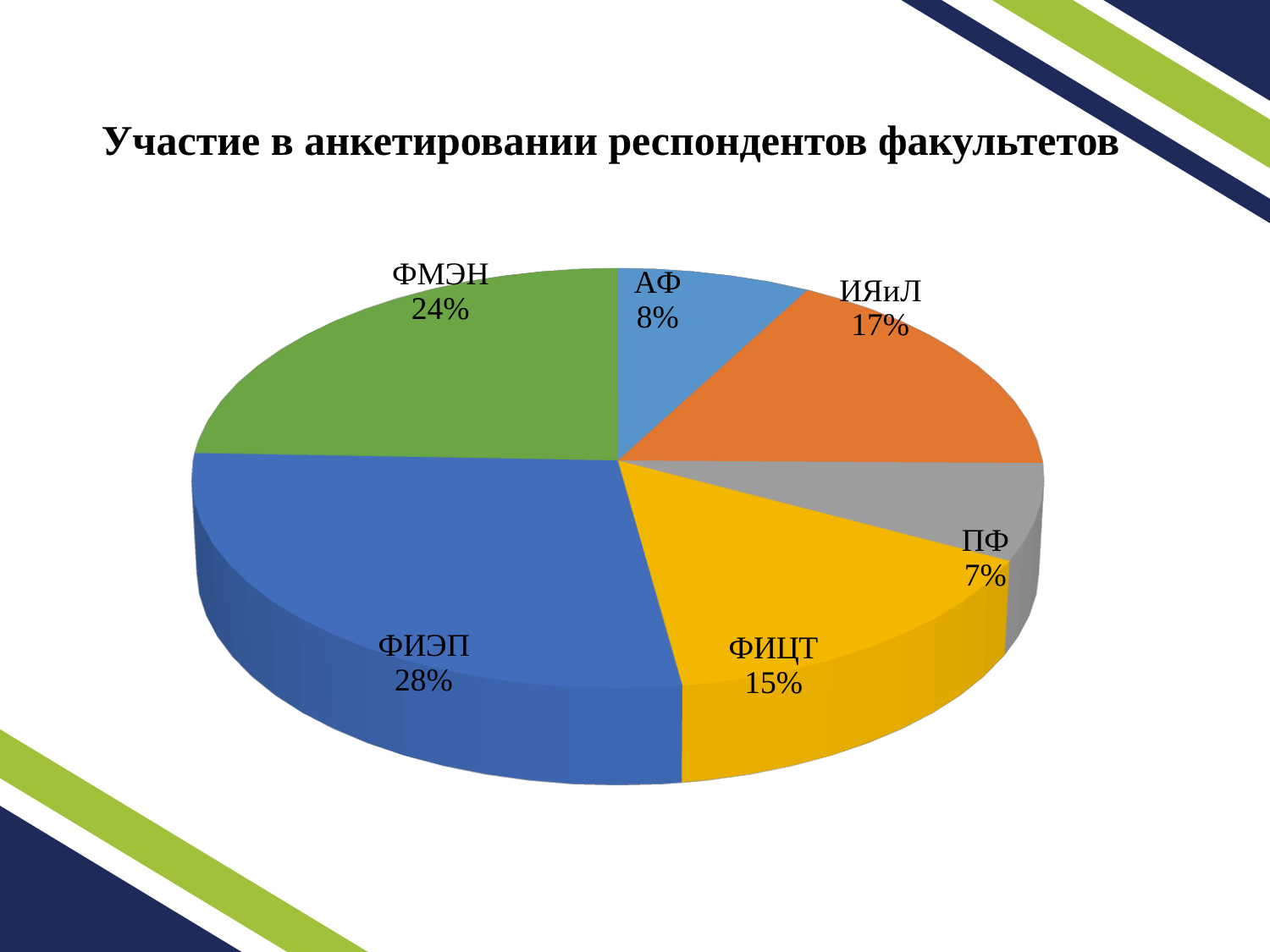
What share of respondents does the ФИЭП slice represent? 28% What percentage is shown for АФ? 8% Which faculty has the largest share of respondents? ФИЭП What is the title of the slide? Участие в анкетировании респондентов факультетов What percentage is shown for ИЯиЛ? 17% What is the difference in percentage points between ФИЭП and ФИЦТ? 13 How many faculties (slices) are shown in the pie chart? 6 What colour is the ФИЦТ slice? Yellow Which faculty has the smallest share of respondents? ПФ Which is larger, the share for ИЯиЛ or the share for ФИЦТ? ИЯиЛ What percentage is shown for ФМЭН? 24% What kind of chart is shown on the slide? Pie chart